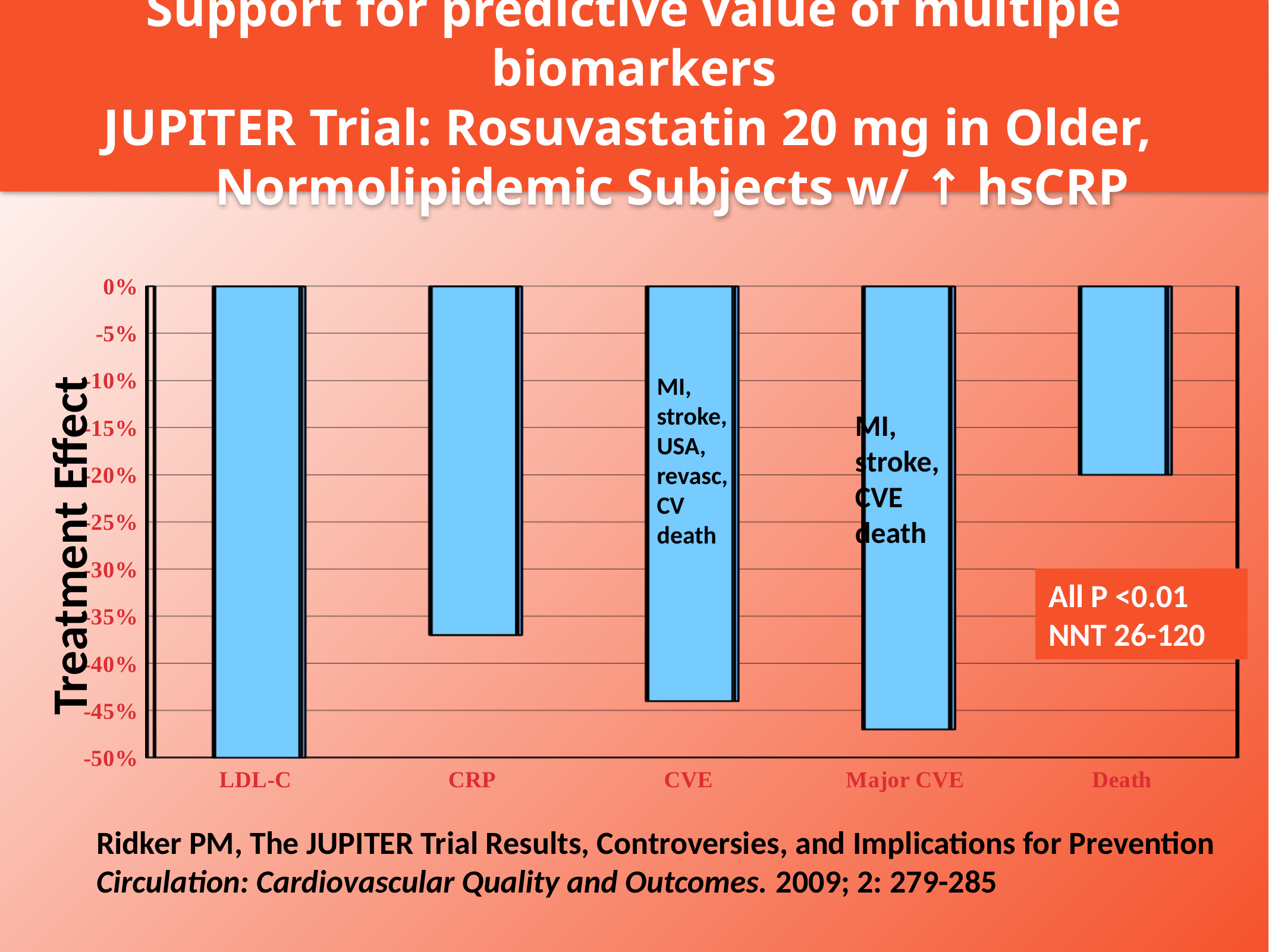
What is the treatment effect value for LDL-C? -50% Is the treatment effect value for CVE greater or less than -40%? less Which has the more negative treatment effect, CVE or Major CVE? Major CVE What is the title of the vertical axis of the chart? Treatment Effect How many categories are plotted on the x axis of the chart? 5 Which category has the lowest (most negative) treatment effect? LDL-C Is the treatment effect value for Major CVE greater or less than -45%? less Which category has the highest (least negative) treatment effect? Death What kind of chart is shown on the slide? bar chart Is the treatment effect value for CRP greater or less than -35%? less What is the difference in percentage points between the treatment effect for LDL-C and for Death? 30 percentage points What is the treatment effect value for Death? -20%